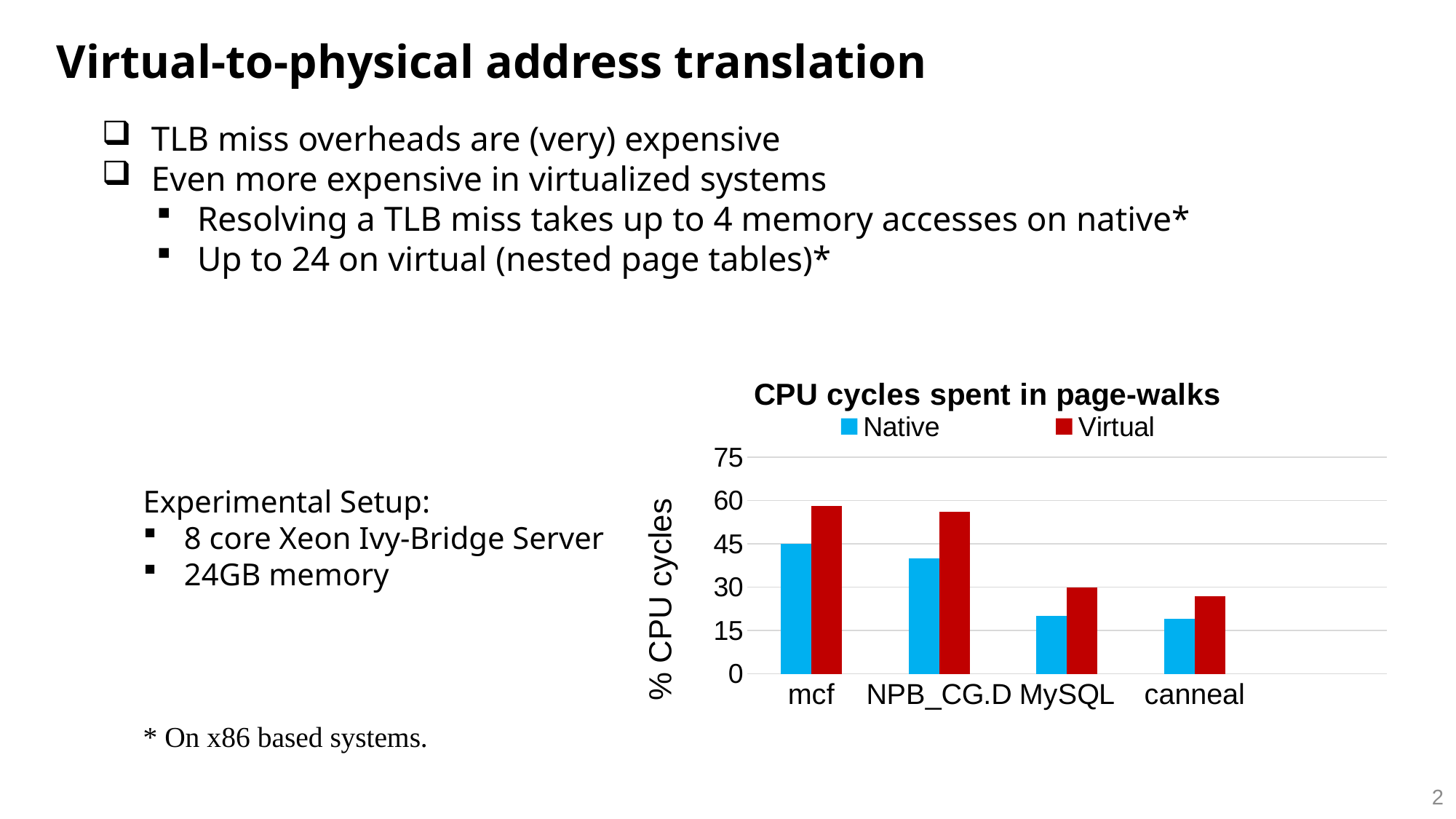
For MySQL, which is larger, the Native value or the Virtual value? Virtual Which category has the highest Virtual value? mcf Is the Virtual value for mcf greater or less than 45? greater Is the Native value for NPB_CG.D greater or less than 45? less Which category has the highest Native value? mcf Is the Virtual value for canneal greater or less than 30? less What kind of chart is shown on the slide? bar chart How many categories are shown on the x axis of the chart? 4 Do the Virtual values rise or fall from left to right across the categories? fall Which category has the lowest Virtual value? canneal Which is larger, the Native value for mcf or the Native value for NPB_CG.D? mcf How many series does the legend of the chart list? 2